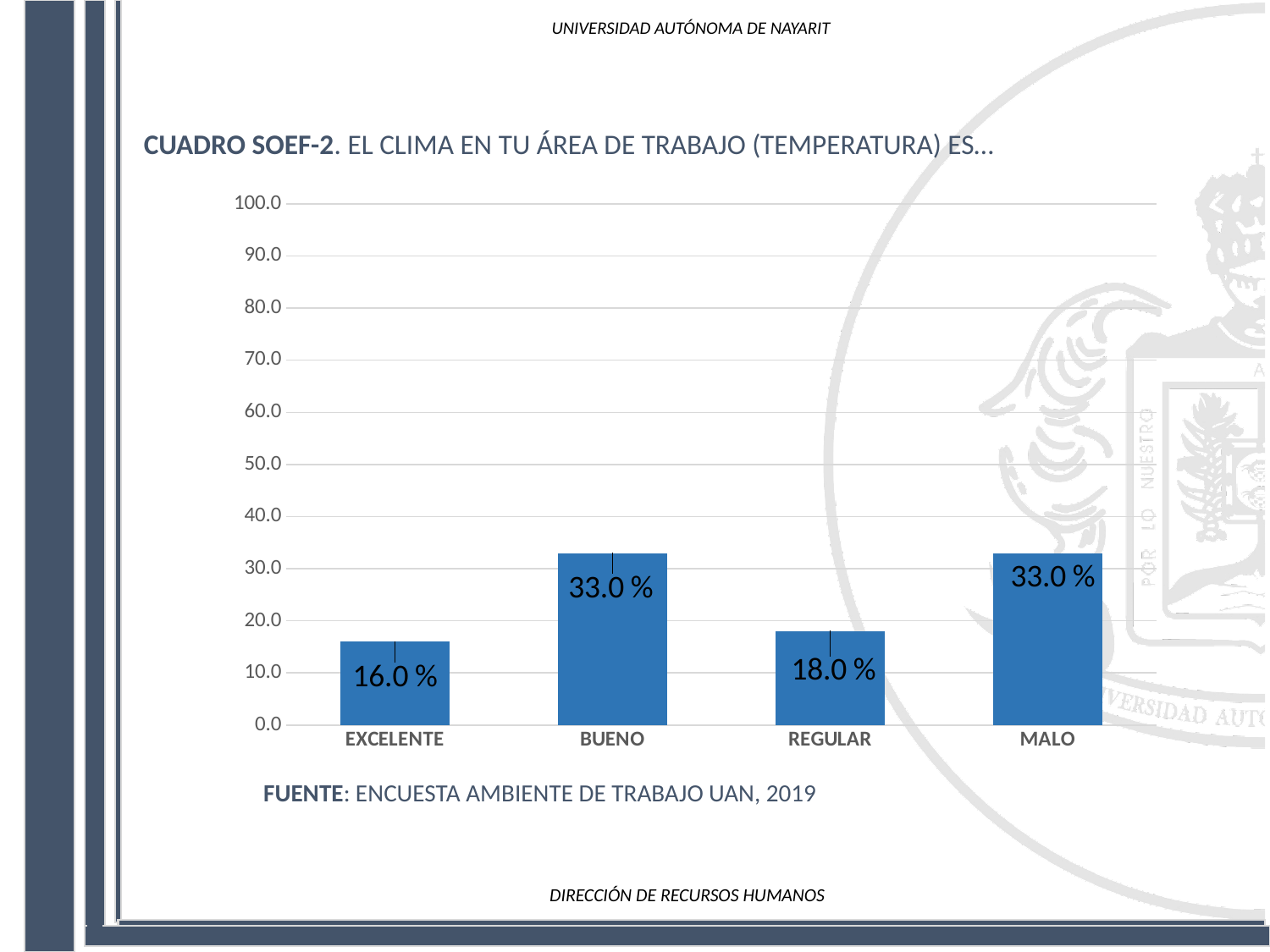
Is the value for EXCELENTE greater or less than 20.0? less What kind of chart is shown on the slide? bar chart Which category has the lowest value? EXCELENTE Which is larger, the value for REGULAR or the value for MALO? MALO What is the value for REGULAR? 18.0 % What source is cited below the chart? ENCUESTA AMBIENTE DE TRABAJO UAN, 2019 How many categories are shown on the x axis? 4 Is the value for MALO greater or less than 30.0? greater What is the value for BUENO? 33.0 % What is the value for EXCELENTE? 16.0 % What is the difference between the values for REGULAR and EXCELENTE? 2.0 % What is the difference between the values for BUENO and EXCELENTE? 17.0 %